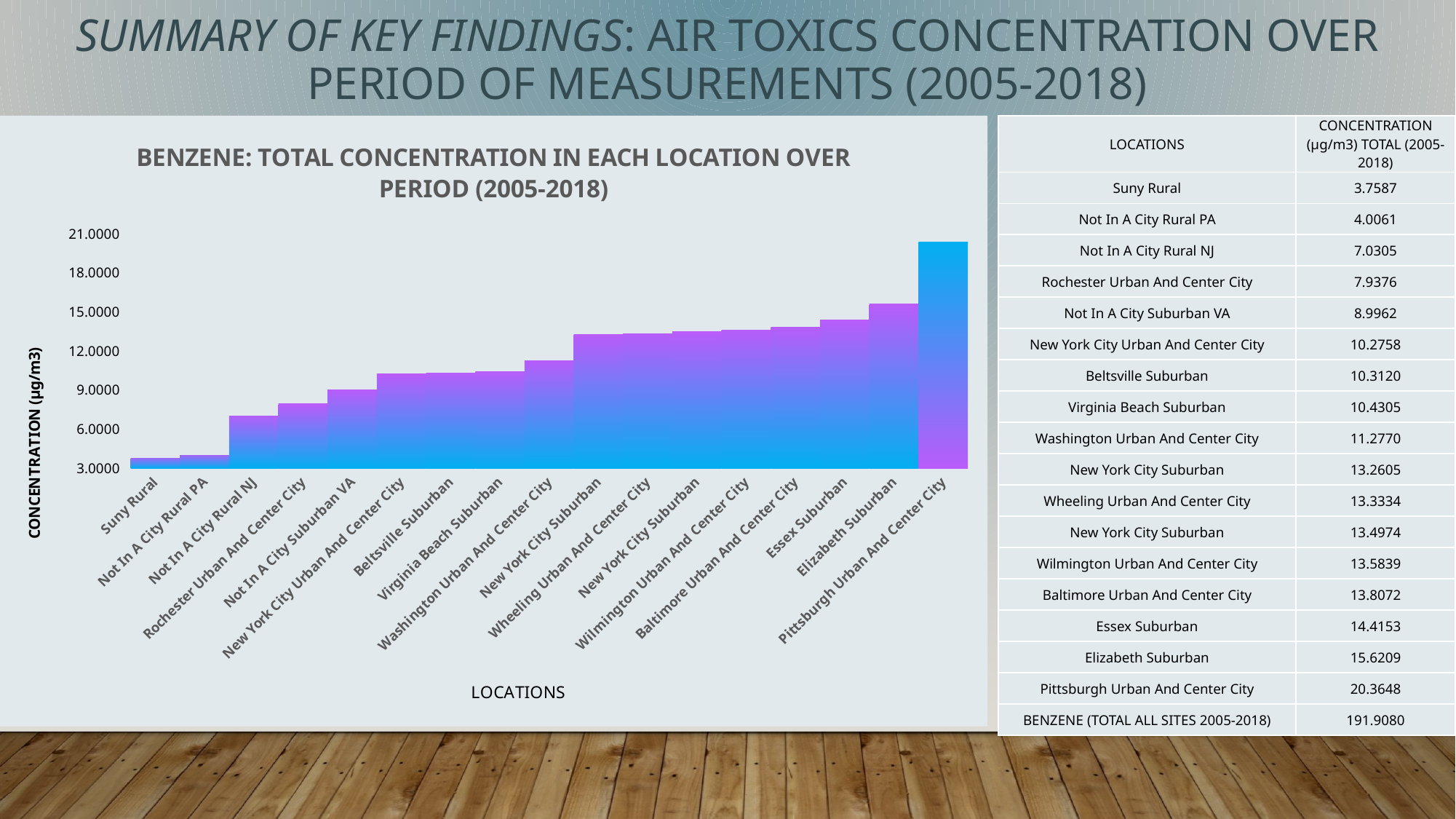
What is the label on the vertical axis of the chart? CONCENTRATION (µg/m3) What is the difference between the benzene concentration for Pittsburgh Urban And Center City and Suny Rural? 16.6061 Do the bar values rise or fall from left to right along the x axis? Rise Which location has the highest total benzene concentration in the chart? Pittsburgh Urban And Center City How many locations are plotted in the Benzene bar chart? 17 Is the value for Not In A City Rural NJ greater or less than 6.0000? greater Which has the larger benzene concentration, Elizabeth Suburban or Essex Suburban? Elizabeth Suburban Which location has the lowest total benzene concentration in the chart? Suny Rural What kind of chart is shown on the slide? Bar chart Is the value for Beltsville Suburban greater or less than 12.0000? less What is the total benzene concentration (µg/m3) for Pittsburgh Urban And Center City? 20.3648 What is the total benzene concentration (µg/m3) for Suny Rural? 3.7587